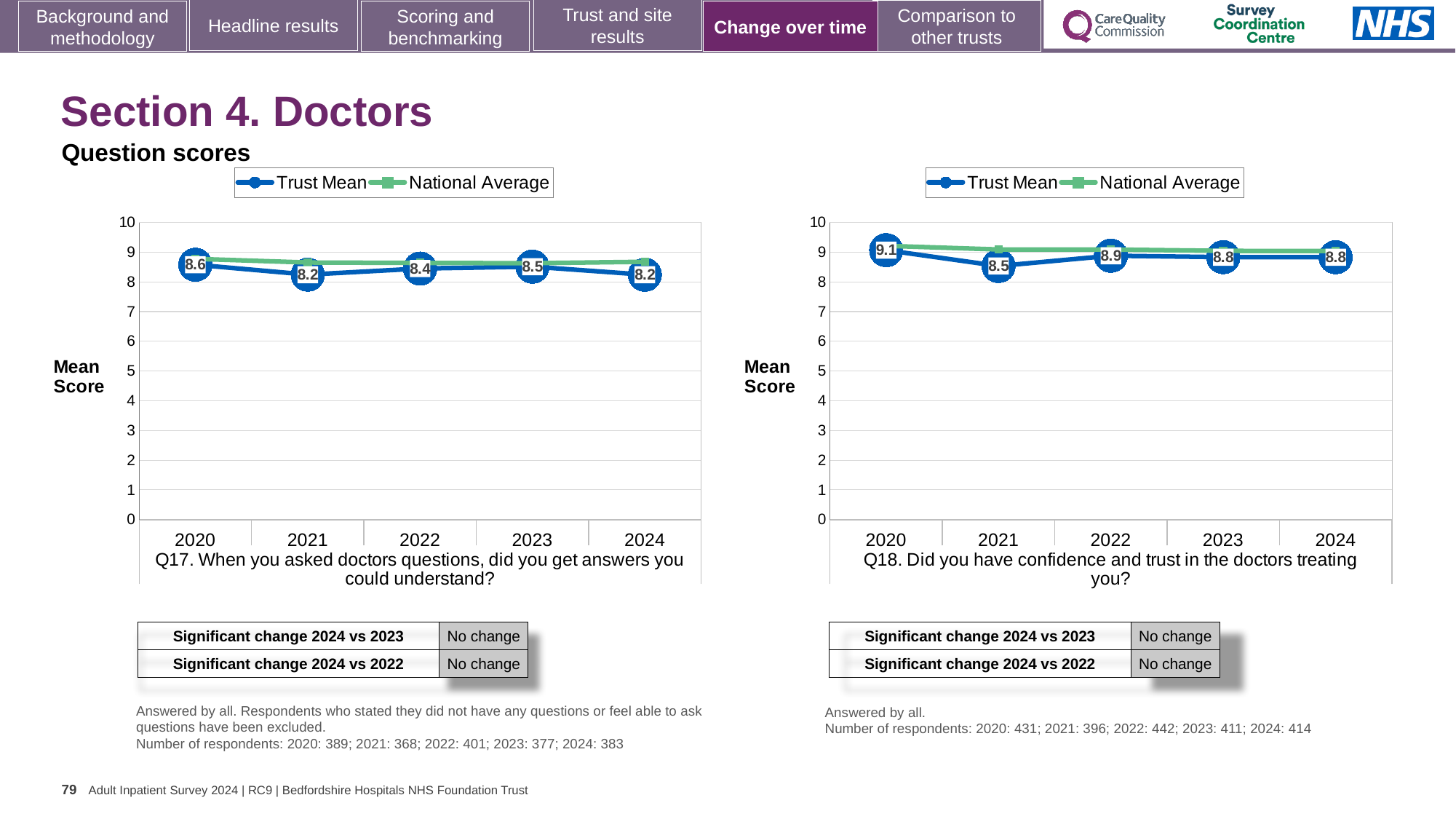
In the Q18 chart (right), what is the Trust Mean score for 2022? 8.9 In the Q18 chart (right), what is the difference between the Trust Mean scores for 2020 and 2021? 0.6 In the Q17 chart (left), which is larger, the Trust Mean score for 2021 or for 2023? 2023 What type of chart is the Q18 chart (right)? Line chart In the Q17 chart (left), what is the Trust Mean score for 2020? 8.6 In the Q17 chart (left), which year has the highest Trust Mean score? 2020 How many years are plotted on the x axis of the Q18 chart (right)? 5 In the Q17 chart (left), what is the Trust Mean score for 2024? 8.2 In the Q17 chart (left), is the National Average for 2024 greater or less than 8? greater In the Q18 chart (right), which year has the lowest Trust Mean score? 2021 How many series does the legend of the Q17 chart (left) list? 2 In the Q18 chart (right), what is the Trust Mean score for 2020? 9.1